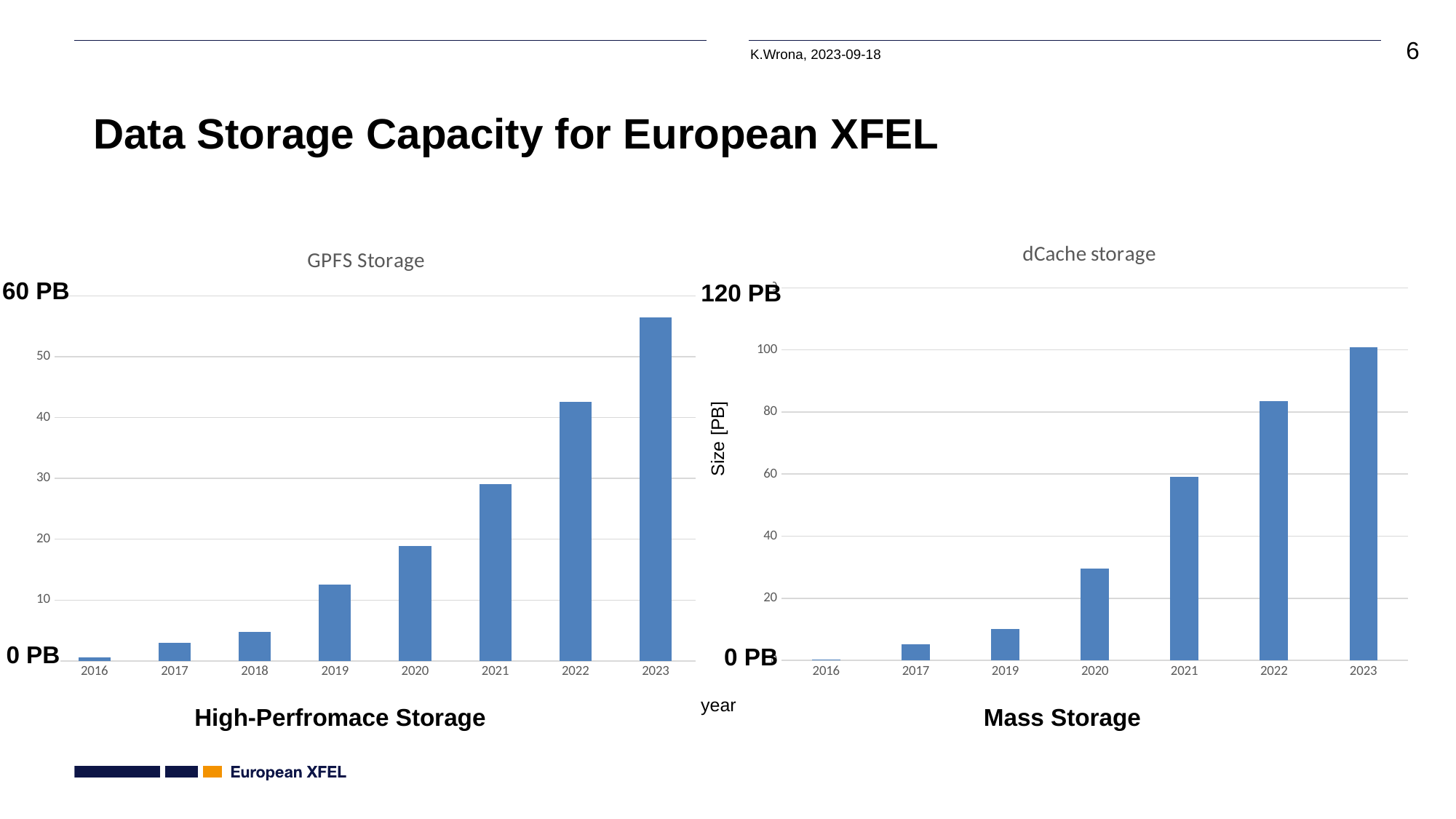
How many years are plotted in the GPFS Storage chart? 8 In the GPFS Storage chart, is the value for 2020 greater or less than 20? less In the GPFS Storage chart, which year has the highest value? 2023 How many years are plotted in the dCache storage chart? 7 What kind of chart is the GPFS Storage chart? bar chart In the GPFS Storage chart, is the value for 2023 greater or less than 50? greater In the dCache storage chart, is the value for 2022 greater or less than 80? greater What is the label on the vertical axis of the dCache storage chart? Size [PB] In the dCache storage chart, which is larger, the value for 2020 or the value for 2021? 2021 In the GPFS Storage chart, do the values rise or fall from 2016 to 2023? rise In the GPFS Storage chart, which year has the lowest value? 2016 In the dCache storage chart, which year has the highest value? 2023